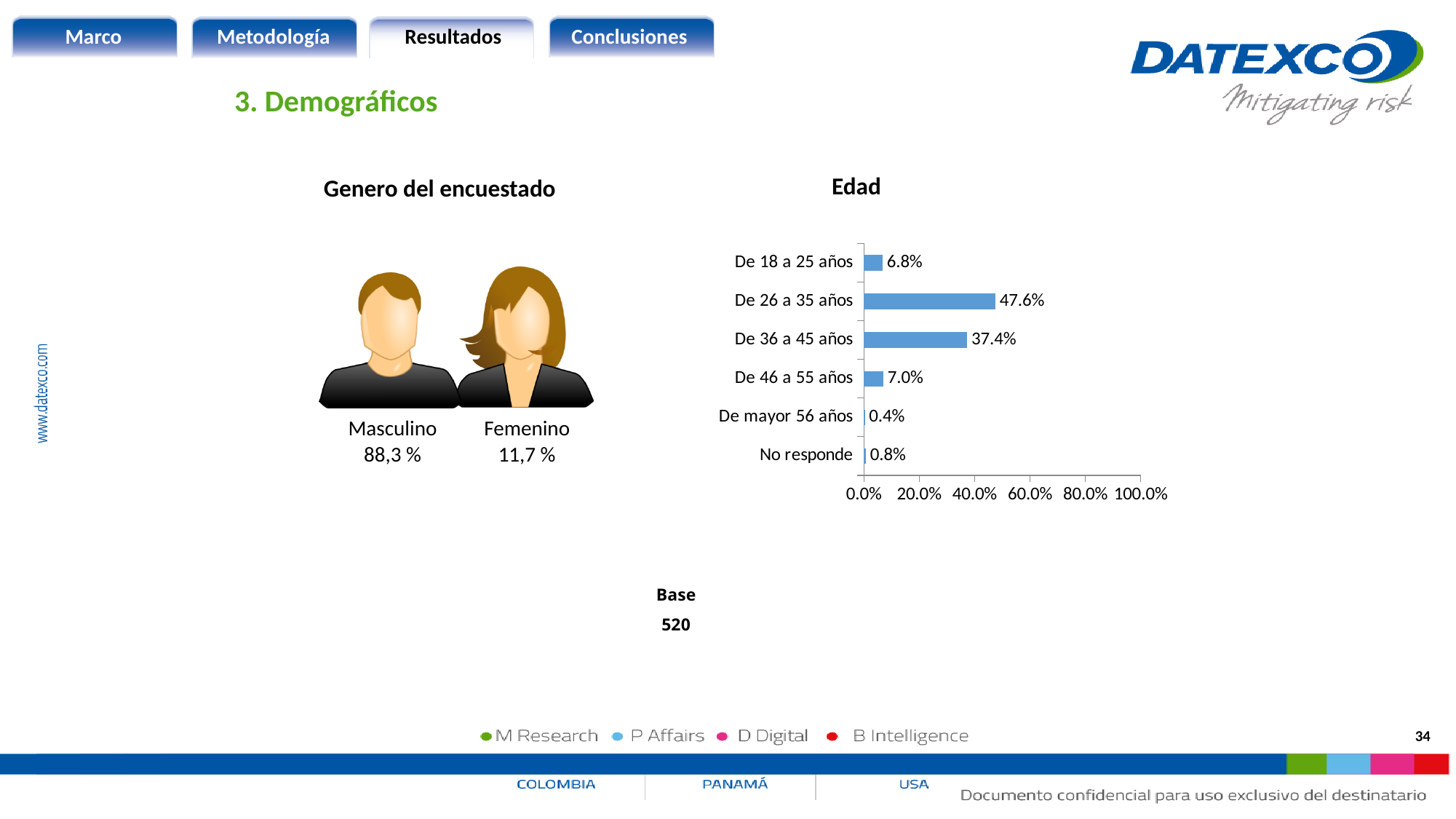
In the 'Edad' chart, which is larger: the value for 'De 46 a 55 años' or 'De 18 a 25 años'? De 46 a 55 años How many categories are shown in the 'Edad' chart? 6 In the 'Edad' chart, which category has the lowest value? De mayor 56 años In the 'Edad' chart, what is the value for 'No responde'? 0.8% In the 'Edad' chart, is the value for 'De 26 a 35 años' greater or less than 40.0%? greater In the 'Edad' chart, what is the value for 'De 26 a 35 años'? 47.6% In the 'Edad' chart, what is the value for 'De mayor 56 años'? 0.4% What kind of chart is the 'Edad' chart? bar chart In the 'Genero del encuestado' graphic, what is the value for 'Masculino'? 88,3 % In the 'Edad' chart, what is the difference between the values for 'De 26 a 35 años' and 'De 36 a 45 años'? 10.2% In the 'Edad' chart, what is the value for 'De 36 a 45 años'? 37.4% In the 'Edad' chart, which age category has the highest value? De 26 a 35 años